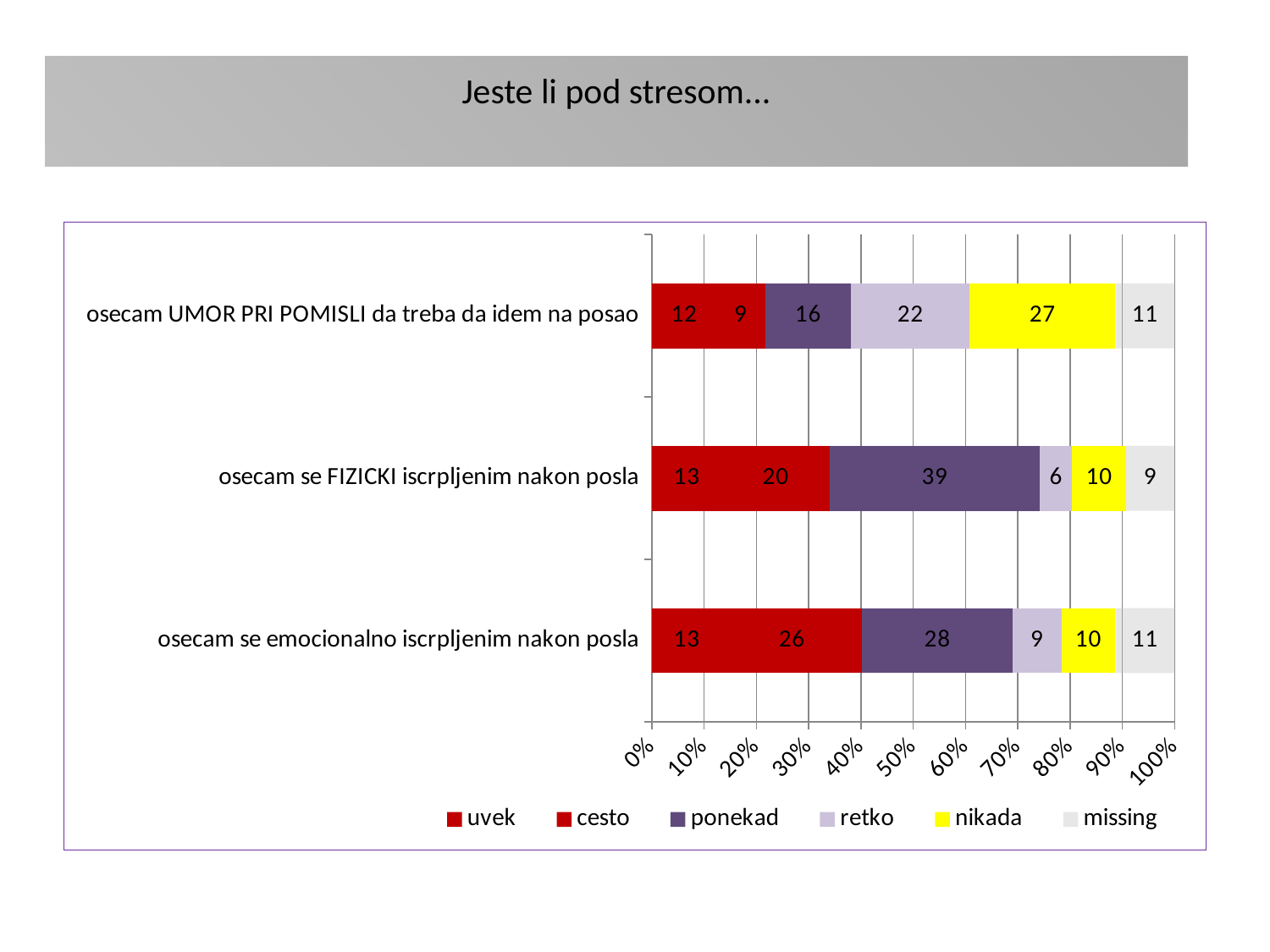
How many series does the legend list? 6 Which has the larger 'missing' value: 'osecam UMOR PRI POMISLI da treba da idem na posao' or 'osecam se FIZICKI iscrpljenim nakon posla'? osecam UMOR PRI POMISLI da treba da idem na posao Which category has the highest value for 'ponekad'? osecam se FIZICKI iscrpljenim nakon posla Which category has the lowest value for 'retko'? osecam se FIZICKI iscrpljenim nakon posla What kind of chart is shown on the slide? bar chart What is the value of 'nikada' for 'osecam UMOR PRI POMISLI da treba da idem na posao'? 27 What is the value of 'retko' for 'osecam se emocionalno iscrpljenim nakon posla'? 9 What is the difference between the 'nikada' value for 'osecam UMOR PRI POMISLI da treba da idem na posao' and the 'nikada' value for 'osecam se FIZICKI iscrpljenim nakon posla'? 17 What is the title shown above the chart? Jeste li pod stresom… How many categories (bars) are plotted in the chart? 3 What is the value of 'ponekad' for 'osecam se FIZICKI iscrpljenim nakon posla'? 39 What is the total of all segments in the bar for 'osecam se FIZICKI iscrpljenim nakon posla'? 97